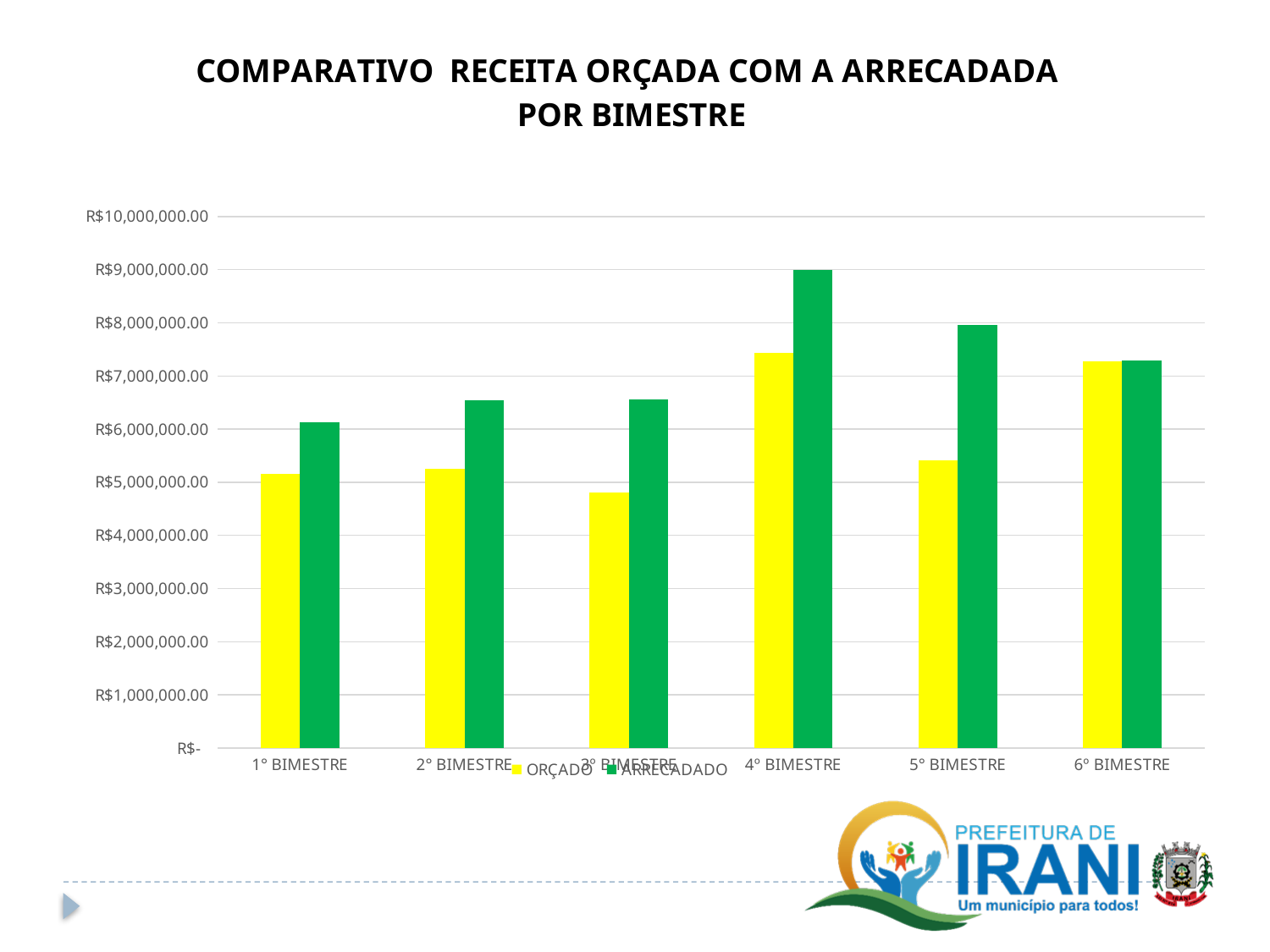
Is the ARRECADADO value for 4º BIMESTRE greater or less than R$8,000,000.00? greater How many bimestres (categories) are shown on the x axis? 6 Is the ARRECADADO value for 5º BIMESTRE greater or less than R$7,000,000.00? greater In 5º BIMESTRE, which is larger, ORÇADO or ARRECADADO? ARRECADADO Which colour represents the ORÇADO series in the chart? yellow Is the ORÇADO value for 1º BIMESTRE greater or less than R$6,000,000.00? less Which bimestre has the lowest ARRECADADO value? 1º BIMESTRE Which bimestre has the highest ARRECADADO value? 4º BIMESTRE Which bimestre has the lowest ORÇADO value? 3º BIMESTRE What kind of chart is shown on the slide? bar chart How many series does the legend list? 2